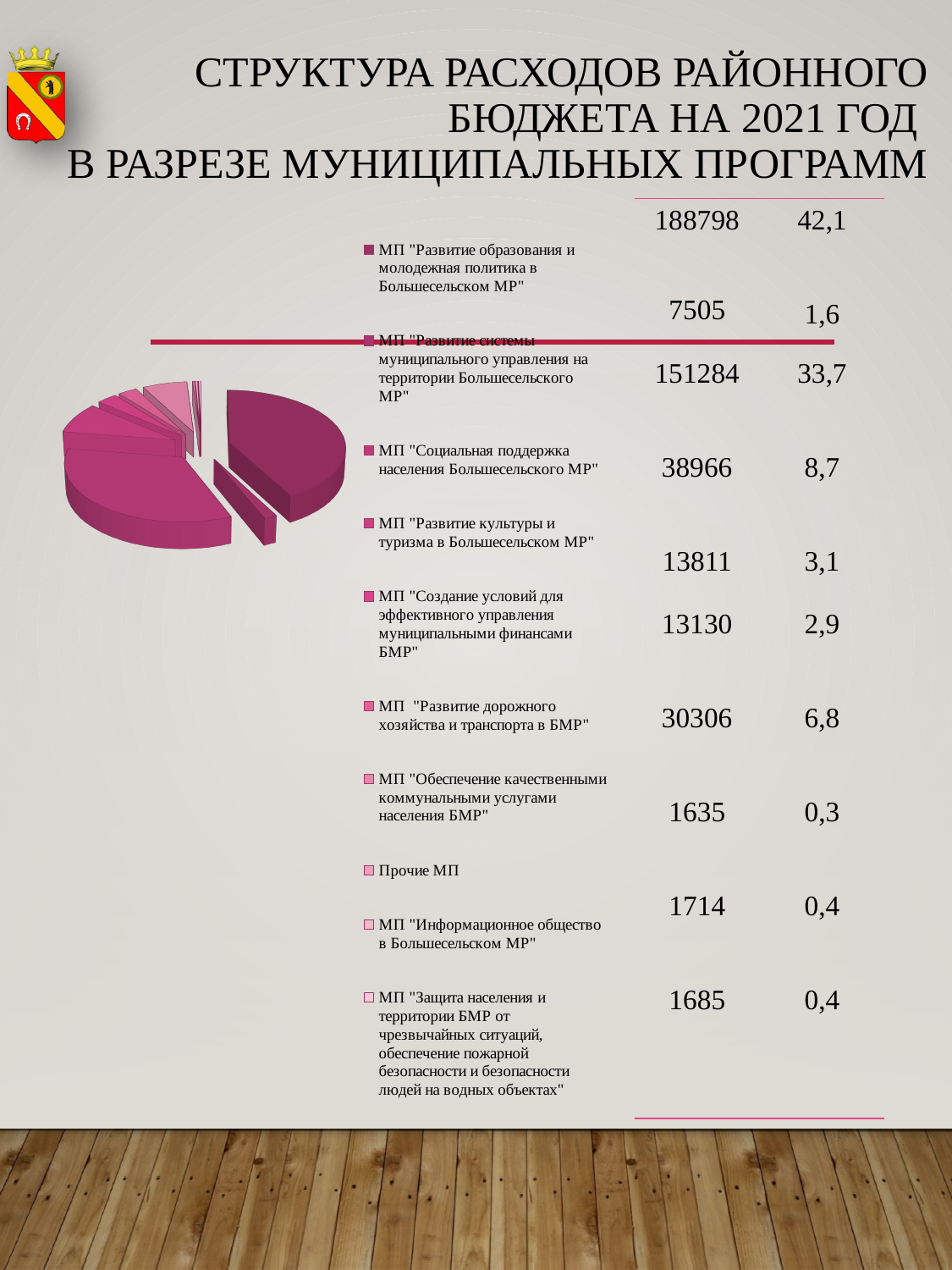
What percentage share is shown for Прочие МП? 0,3 What percentage share is shown for МП "Развитие образования и молодежная политика в Большесельском МР"? 42,1 What is the difference between the amounts for МП "Развитие образования и молодежная политика в Большесельском МР" (188798) and МП "Социальная поддержка населения Большесельского МР" (151284)? 37514 What amount is shown for МП "Развитие дорожного хозяйства и транспорта в БМР"? 13130 What is the difference in percentage points between the share for МП "Развитие образования и молодежная политика в Большесельском МР" (42,1) and МП "Социальная поддержка населения Большесельского МР" (33,7)? 8,4 What amount is shown for МП "Социальная поддержка населения Большесельского МР"? 151284 What is the title of the slide containing the pie chart? СТРУКТУРА РАСХОДОВ РАЙОННОГО БЮДЖЕТА НА 2021 ГОД В РАЗРЕЗЕ МУНИЦИПАЛЬНЫХ ПРОГРАММ Which municipal programme has the largest share of the 2021 district budget expenditure? МП "Развитие образования и молодежная политика в Большесельском МР" What percentage share is shown for МП "Развитие культуры и туризма в Большесельском МР"? 8,7 What kind of chart is shown on the slide? pie chart Which is larger: the share for МП "Развитие образования и молодежная политика в Большесельском МР" or for МП "Социальная поддержка населения Большесельского МР"? МП "Развитие образования и молодежная политика в Большесельском МР" How many categories does the legend of the pie chart list? 10